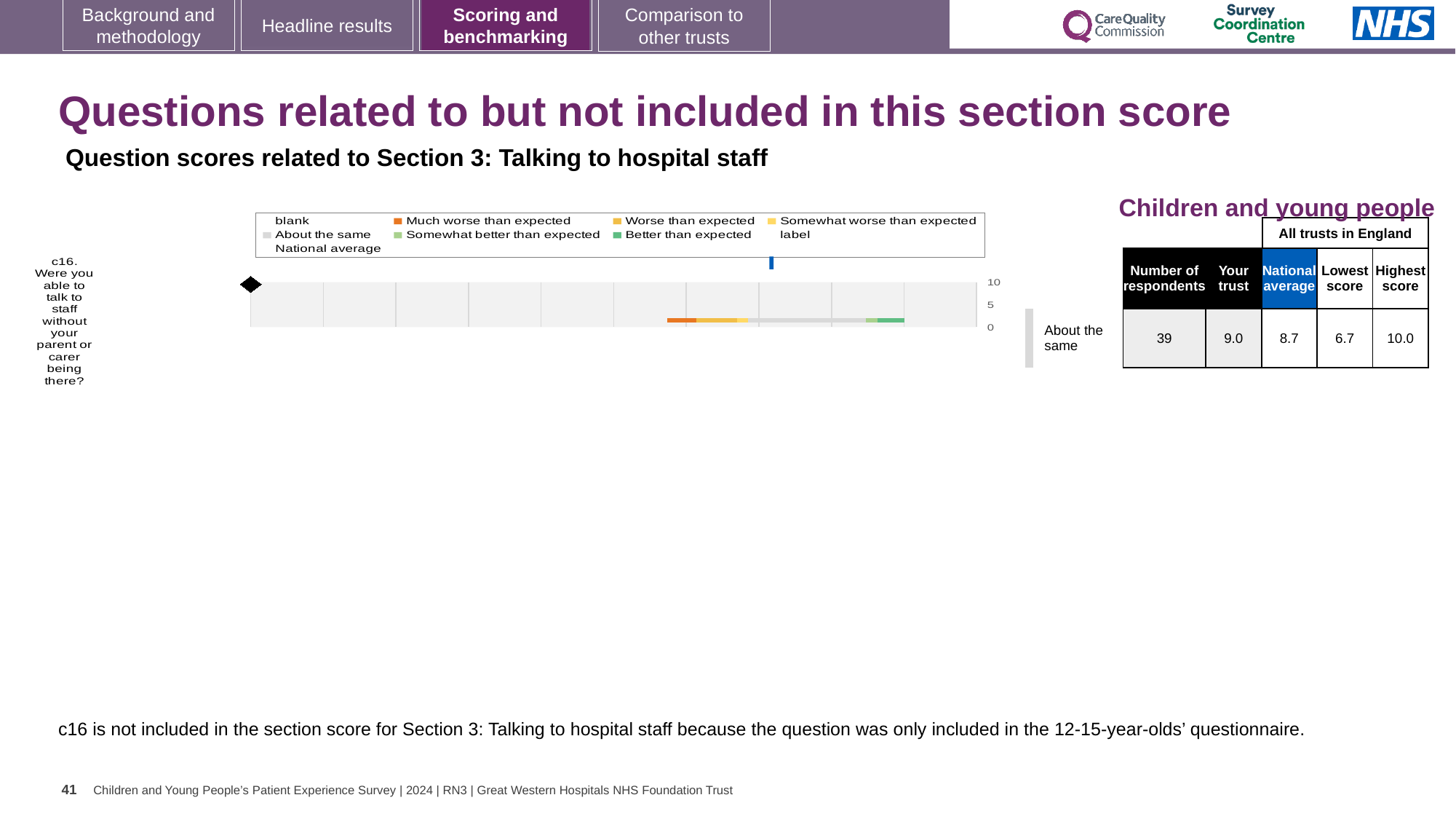
In the table beside the chart, what is the national average score for c16? 8.7 Which is larger for c16: the trust's score or the national average? the trust's score What colour represents 'Much worse than expected' in the chart legend? orange In the table beside the chart, how many respondents answered c16? 39 What benchmark category is shown for question c16? About the same What is the highest value shown on the chart's numeric axis? 10 Which question number is plotted in the chart? c16 What kind of chart is shown on the slide? bar chart What is the difference between the trust's score and the national average for c16? 0.3 How many survey questions are plotted in the chart? 1 In the table beside the chart, what is the 'Your trust' score for c16? 9.0 What is the difference between the highest score and the lowest score for c16 in the table? 3.3